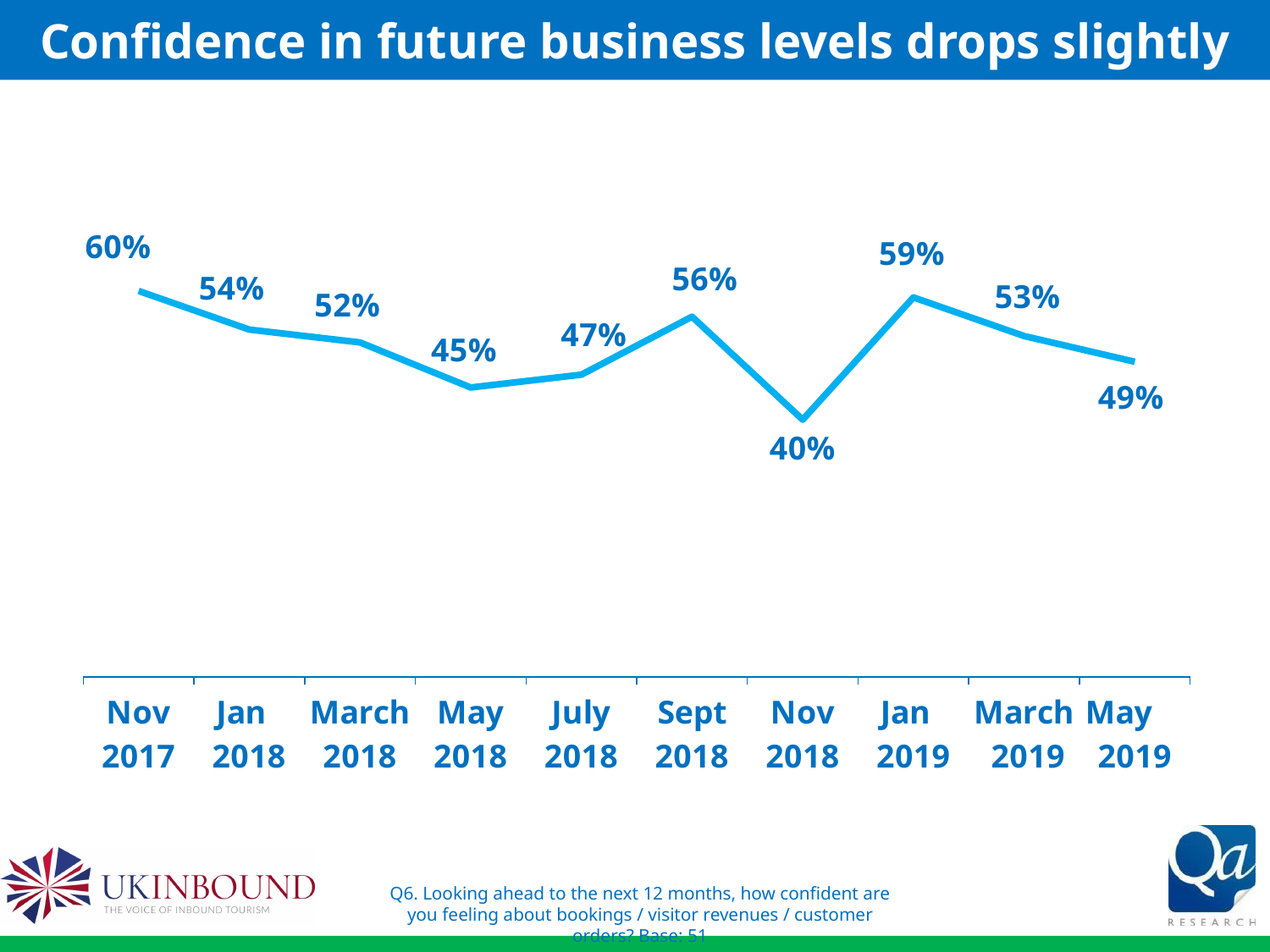
Which is larger, the value for May 2018 or the value for July 2018? July 2018 Which period has the lowest value? Nov 2018 What kind of chart is shown on the slide? Line chart Which period has the highest value? Nov 2017 How many data points are plotted on the chart? 10 What is the title of the slide? Confidence in future business levels drops slightly What is the value for May 2019? 49% What is the difference between the values for Jan 2019 and Nov 2018? 19% What is the value for Nov 2017? 60% Do the values rise or fall from Nov 2017 to May 2018? Fall What is the difference between the values for March 2019 and May 2019? 4% What is the value for Sept 2018? 56%